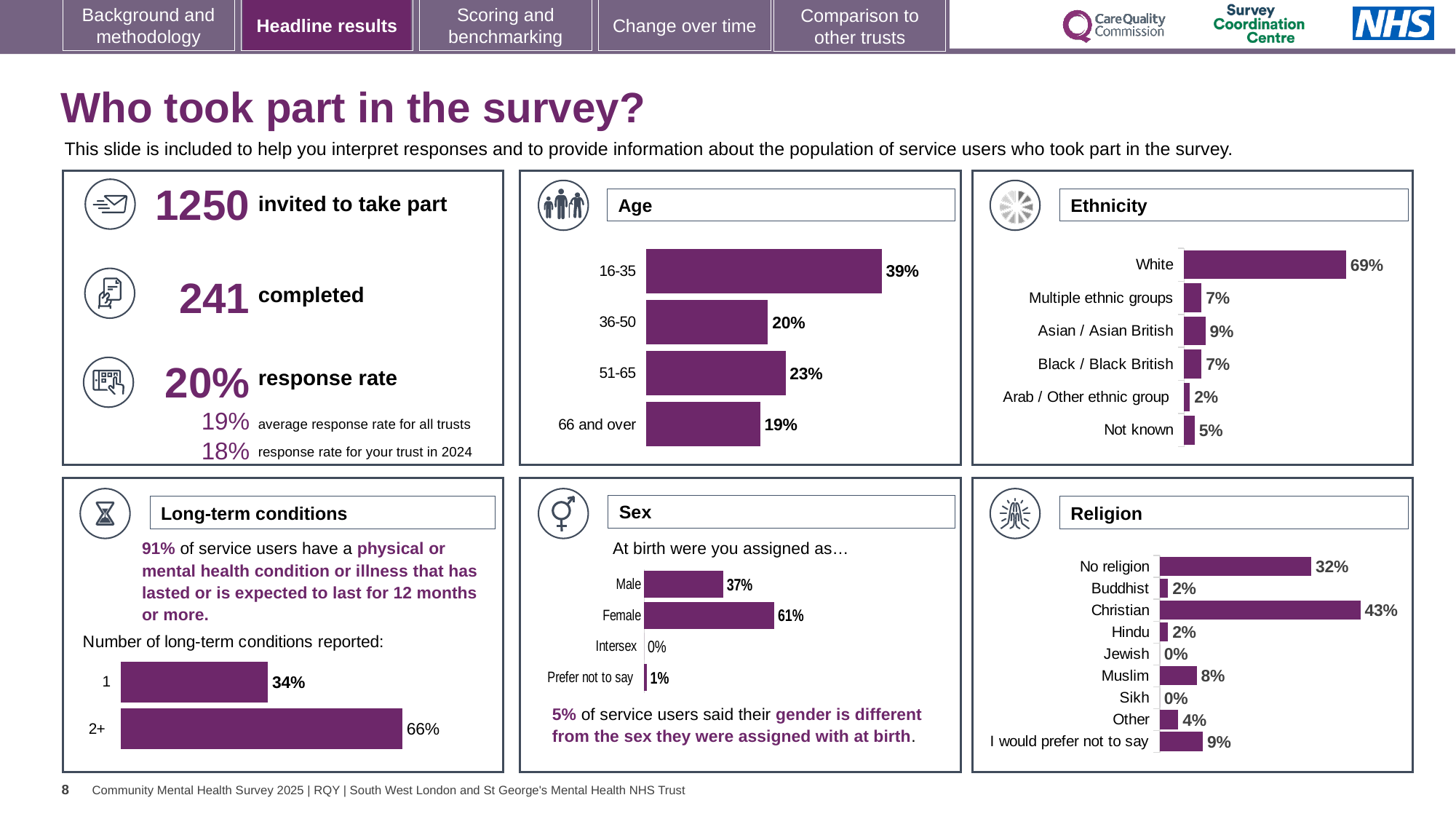
In the Religion chart, how many categories are listed? 9 In the Sex chart, what is the difference between Female and Male? 24% In the Religion chart, what is the difference between Christian and No religion? 11% In the Age chart, which age group has the lowest percentage? 66 and over In the Age chart, what percentage of respondents were aged 16-35? 39% In the Long-term conditions chart, what percentage reported 2+ conditions? 66% In the Sex chart, what percentage of respondents were assigned Female at birth? 61% In the Religion chart, which is larger, Muslim or Other? Muslim In the Ethnicity chart, how many categories are shown? 6 In the Ethnicity chart, which category has the highest value? White In the Ethnicity chart, what is the value for Asian / Asian British? 9% What kind of chart is the Age chart? Bar chart